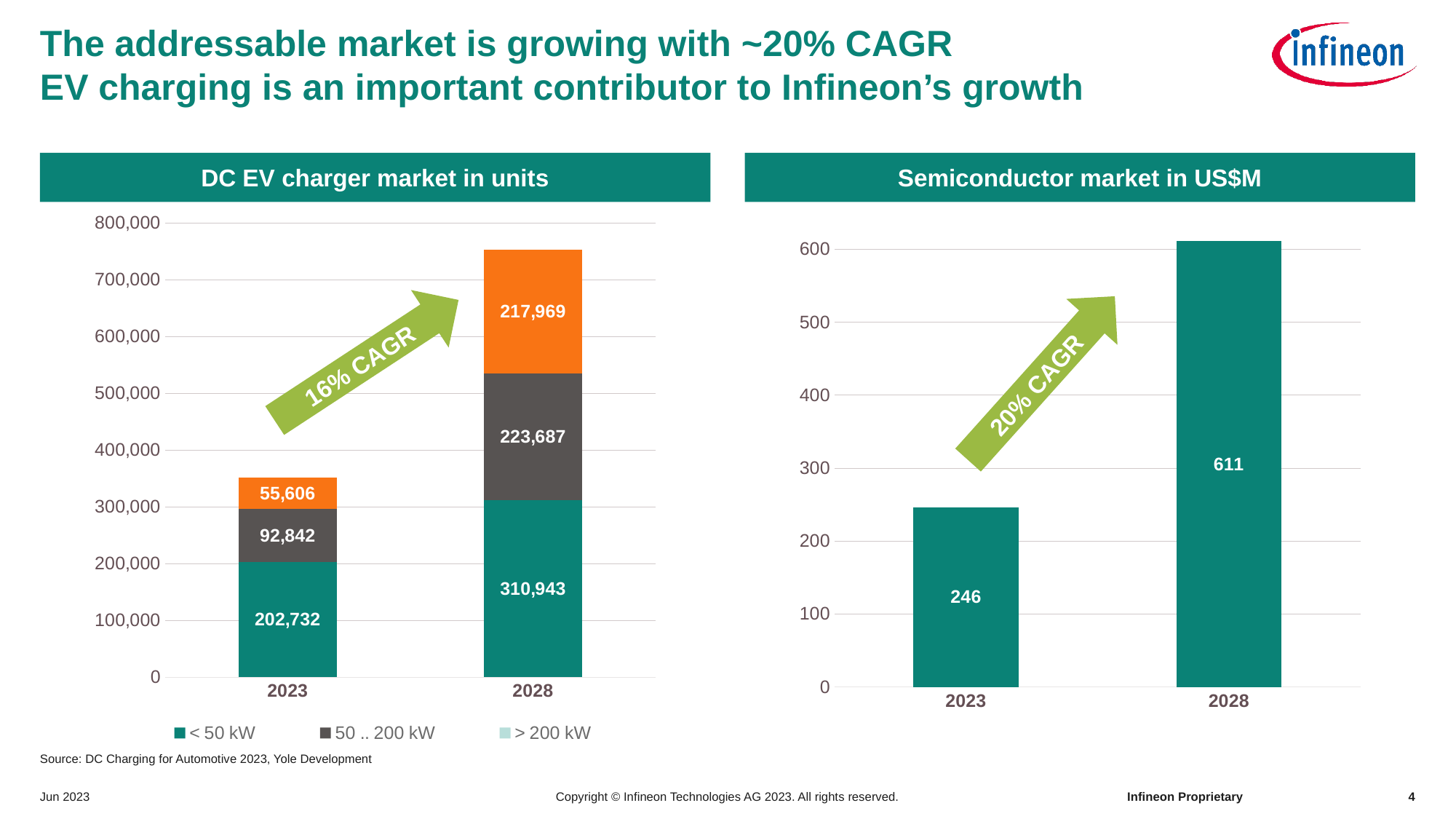
In the 'DC EV charger market in units' chart, how much larger is the '< 50 kW' segment in 2028 than in 2023? 108,211 What kind of chart is the 'Semiconductor market in US$M' chart? Bar chart In the 'DC EV charger market in units' chart, what is the value of the top segment of the 2023 bar? 55,606 In the 'DC EV charger market in units' chart, what is the value of the '50 .. 200 kW' segment for 2028? 223,687 In the 'Semiconductor market in US$M' chart, which year has the higher value? 2028 In the 'Semiconductor market in US$M' chart, what is the difference between the 2028 and 2023 values? 365 In the 'DC EV charger market in units' chart, what is the total of the stacked bar for 2023? 351,180 In the 'Semiconductor market in US$M' chart, what is the value for 2028? 611 In the 'DC EV charger market in units' chart, what is the value of the '< 50 kW' segment for 2023? 202,732 In the 'DC EV charger market in units' chart, what is the total of the stacked bar for 2028? 752,599 In the 'Semiconductor market in US$M' chart, what is the value for 2023? 246 In the 'DC EV charger market in units' chart, how many series does the legend list? 3